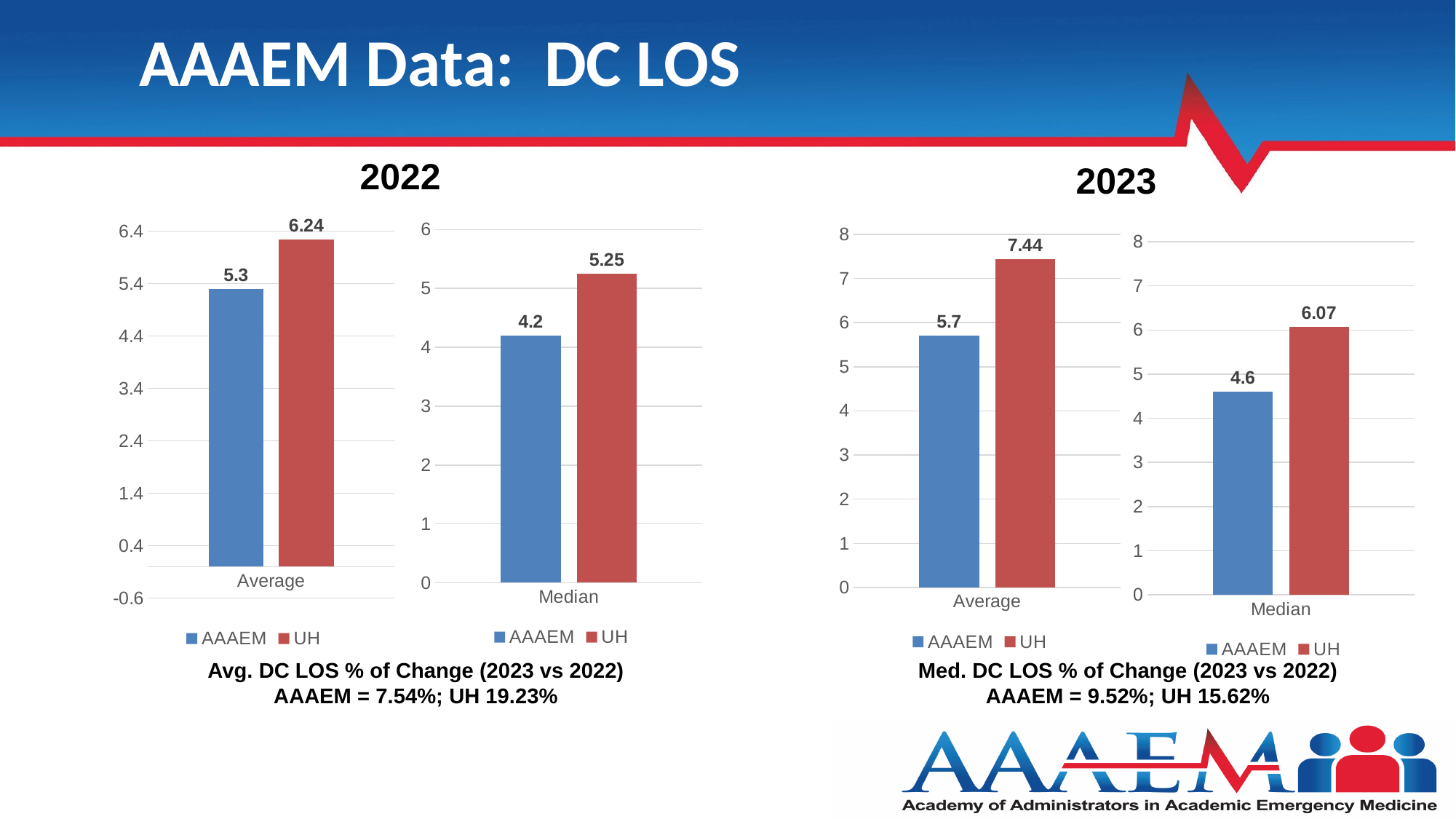
How many series does the legend of the 2022 Average chart list? 2 In the 2023 Median chart, what is the value for AAAEM? 4.6 In the 2022 Average chart, what is the value for AAAEM? 5.3 In the 2023 Median chart, is the value for UH greater or less than 5? greater What kind of chart is the 2023 Median chart? Bar chart In the 2023 Average chart, what is the value for UH? 7.44 In the 2023 Median chart, which series has the higher value, AAAEM or UH? UH In the 2022 Median chart, what is the difference between the UH and AAAEM values? 1.05 In the 2023 Average chart, what is the difference between the UH and AAAEM values? 1.74 In the 2022 Median chart, what is the value for UH? 5.25 In the 2022 Average chart, what is the value for UH? 6.24 In the 2022 Average chart, which colour represents UH? Red